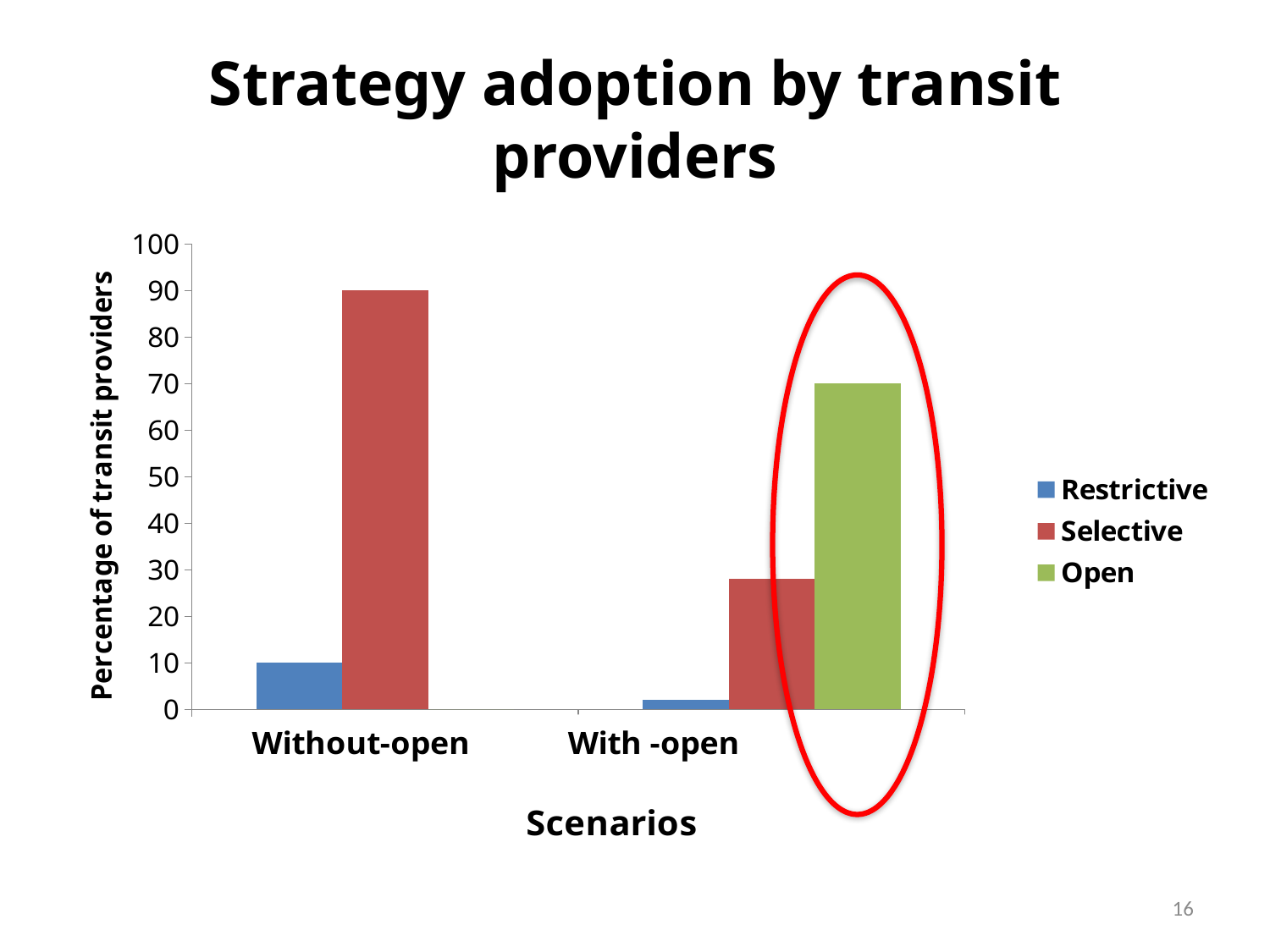
What kind of chart is shown on the slide? bar chart What is the percentage of transit providers for Selective in the Without-open scenario? 90 What is the difference between the Selective and Restrictive values in the Without-open scenario? 80 Is the value for Selective in the With -open scenario greater or less than 30? less What is the title of the chart? Strategy adoption by transit providers Which is larger: Selective in the Without-open scenario or Open in the With -open scenario? Selective in the Without-open scenario How many series does the legend list? 3 Which series has the highest value in the Without-open scenario? Selective Which series has the lowest value in the With -open scenario? Restrictive What is the percentage of transit providers for Open in the With -open scenario? 70 What is the percentage of transit providers for Restrictive in the Without-open scenario? 10 How many scenario categories are shown on the x axis? 2